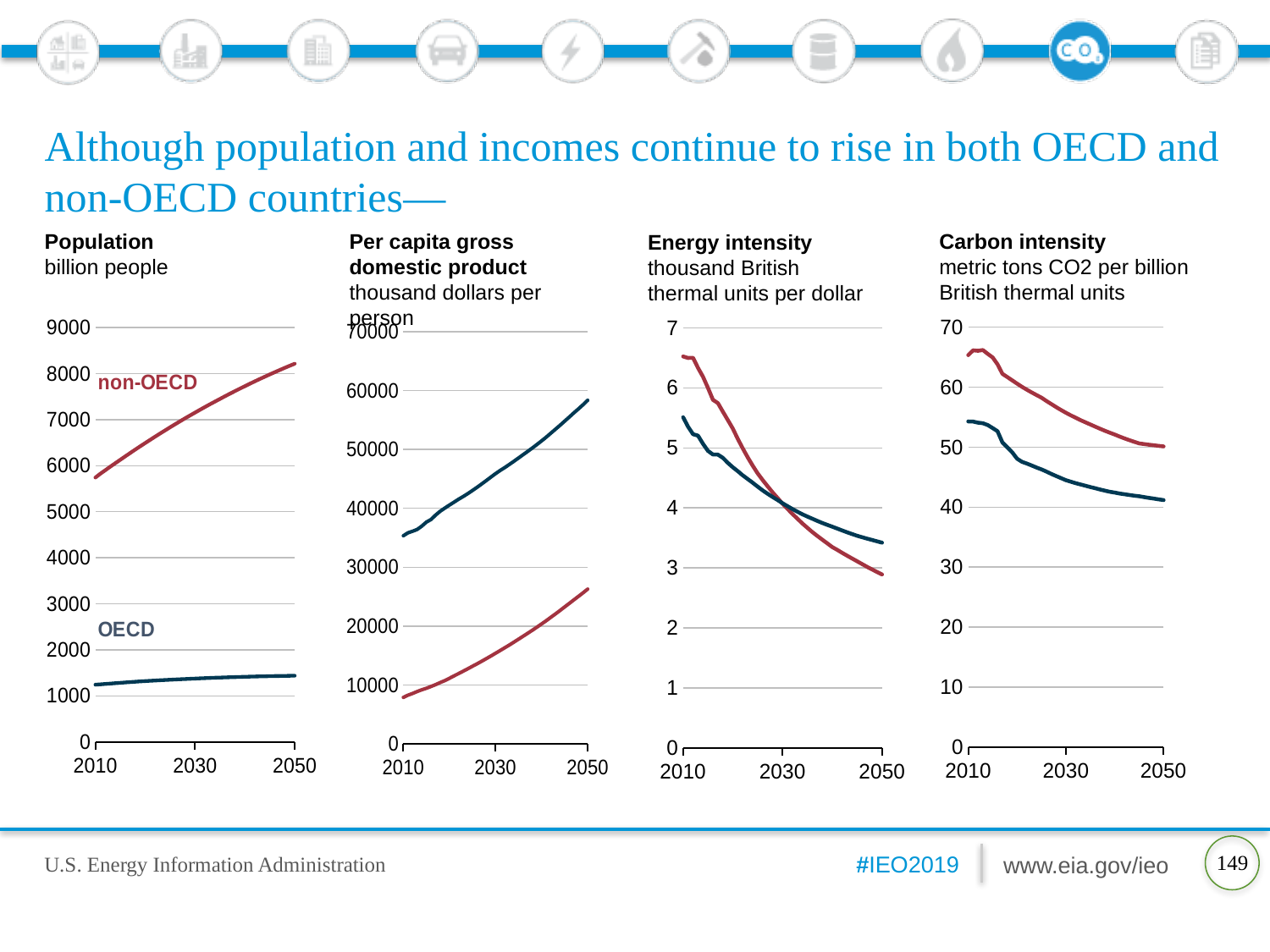
In the Per capita gross domestic product chart, is the non-OECD value in 2010 greater or less than 10000? less What kind of chart is the Population chart? line chart In the Population chart, is the OECD value in 2010 greater or less than 2000? less In the Energy intensity chart, which series has the higher value in 2050, OECD or non-OECD? OECD In the Energy intensity chart, does the non-OECD line rise or fall from 2010 to 2050? falls In the Population chart, does the non-OECD line rise or fall from 2010 to 2050? rises In the Carbon intensity chart, is the non-OECD value in 2050 greater or less than 40? greater How many series are labelled in the Population chart? 2 In the Energy intensity chart, which series has the higher value in 2010, OECD or non-OECD? non-OECD